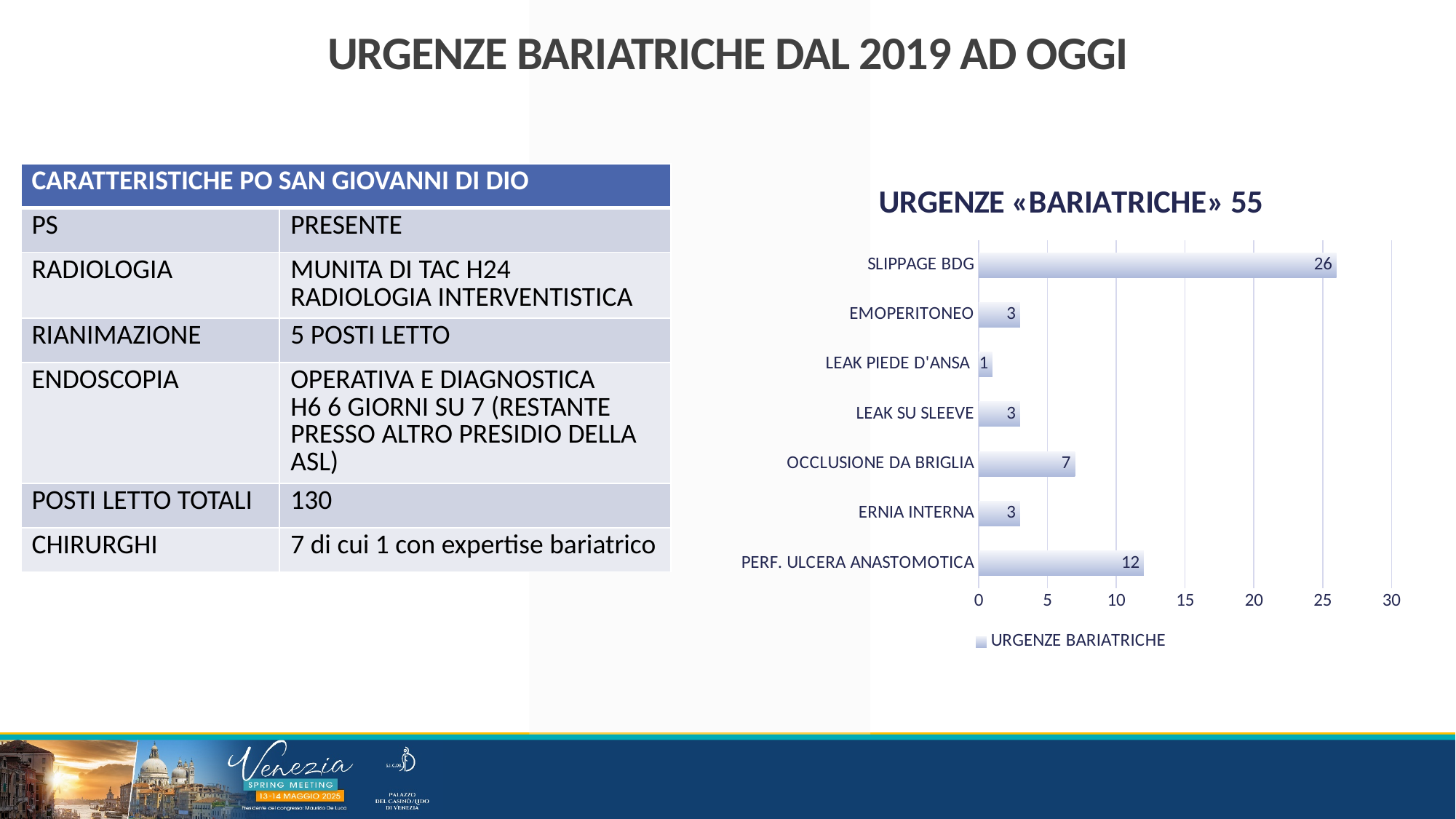
Which category has the highest value? SLIPPAGE BDG What is the value for PERF. ULCERA ANASTOMOTICA? 12 What kind of chart is shown on the slide? bar chart What is the value for OCCLUSIONE DA BRIGLIA? 7 How many categories are shown in the chart? 7 What is the difference between the values for SLIPPAGE BDG and PERF. ULCERA ANASTOMOTICA? 14 What is the value for SLIPPAGE BDG? 26 What is the value for LEAK PIEDE D'ANSA? 1 Is the value for SLIPPAGE BDG greater or less than 20? greater Which category has the lowest value? LEAK PIEDE D'ANSA What is the title of the chart? URGENZE «BARIATRICHE» 55 Which is larger, the value for OCCLUSIONE DA BRIGLIA or the value for EMOPERITONEO? OCCLUSIONE DA BRIGLIA